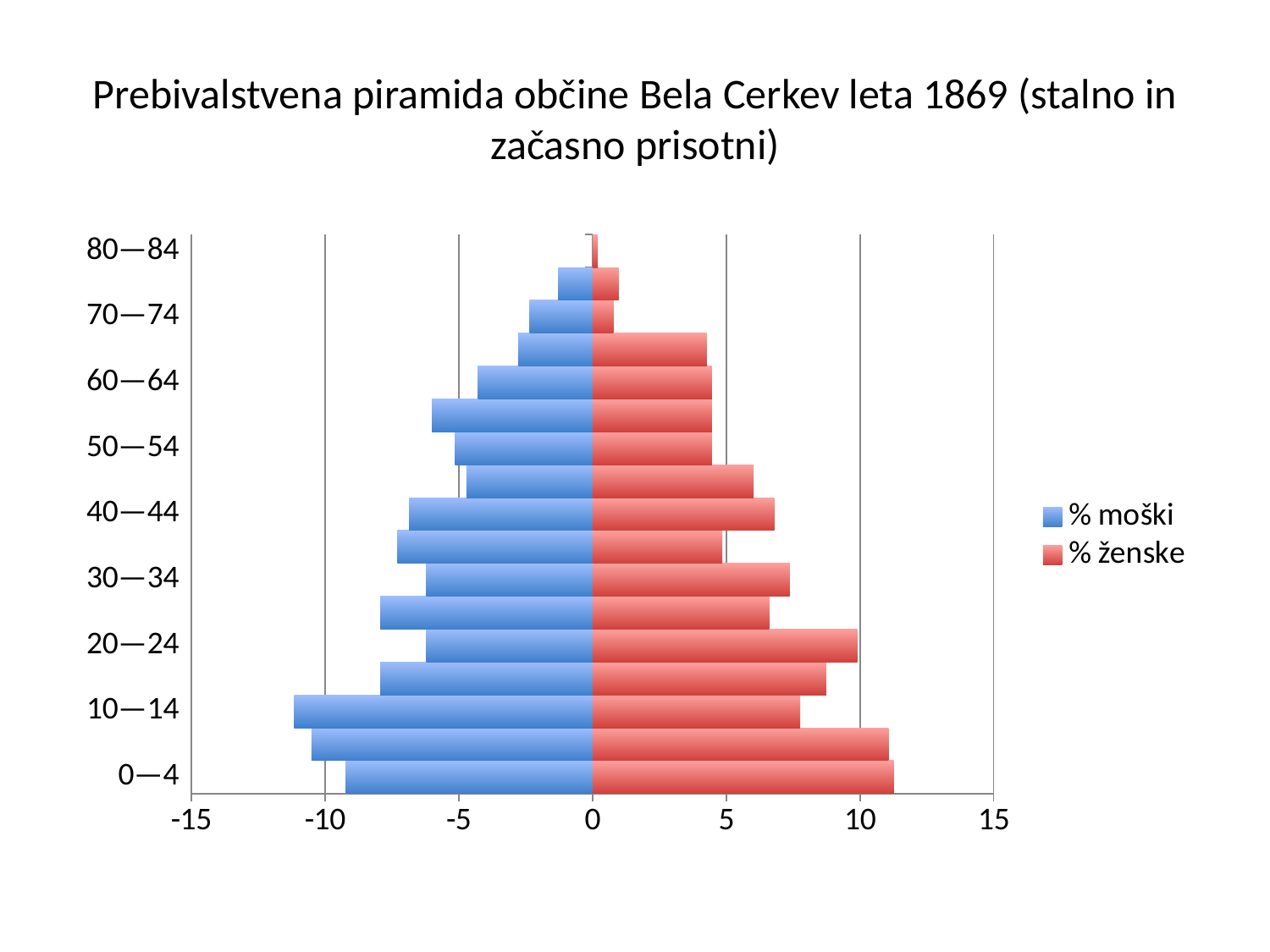
Which age group has the shortest % ženske bar? 80—84 Which age group has the longest % moški bar? 10—14 How many series does the legend list? 2 How many age-group labels are shown on the vertical axis? 9 Is the % moški value for the 10—14 age group less or greater than -10? less Is the % ženske value for the 0—4 age group greater or less than 10? greater Which colour represents % ženske? red What kind of chart is shown on the slide? bar chart Is the % ženske value for the 30—34 age group greater or less than 5? greater What are the two series named in the legend? % moški and % ženske For the 10—14 age group, which bar is longer, % moški or % ženske? % moški For the 30—34 age group, which bar is longer, % moški or % ženske? % ženske